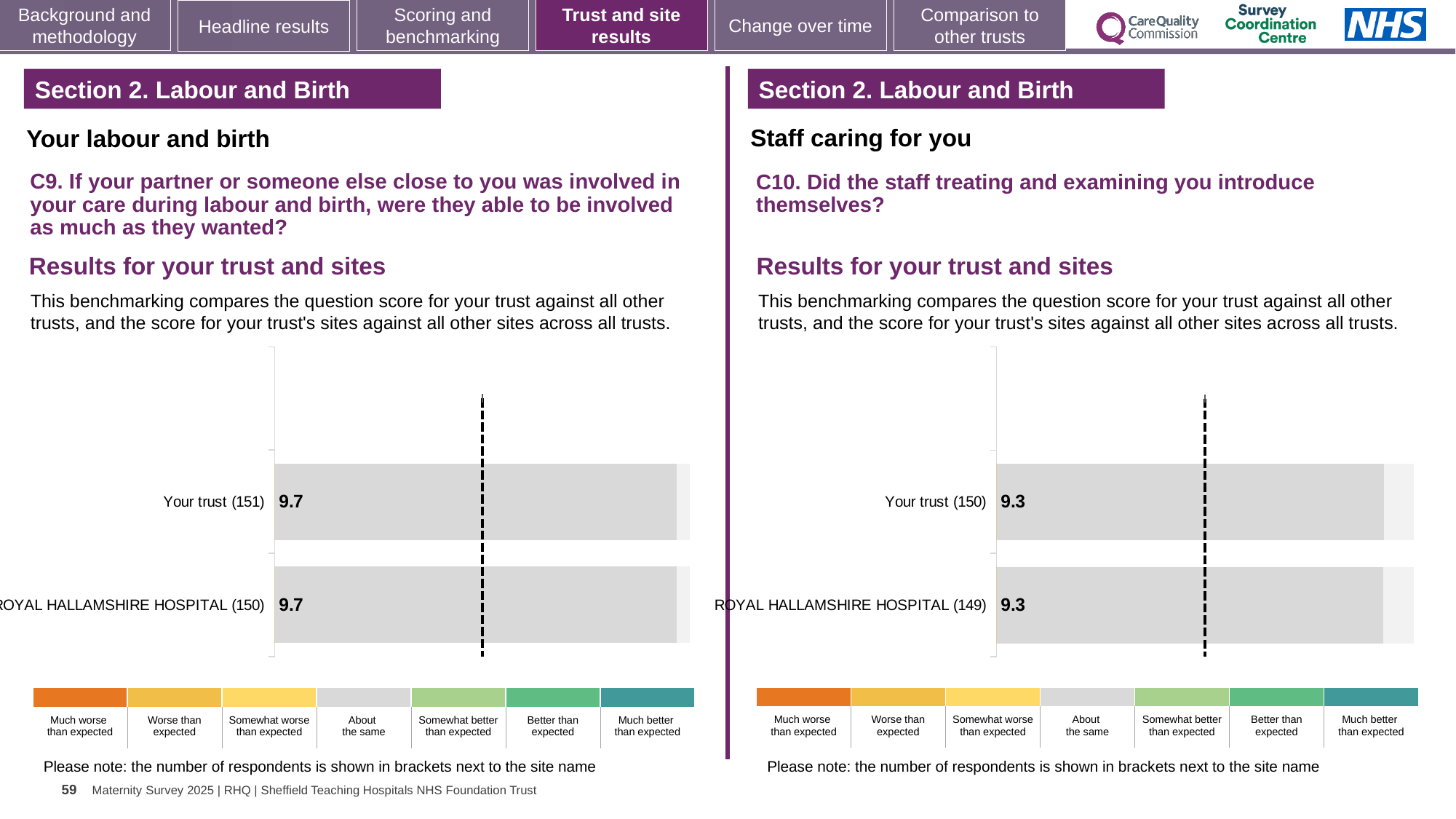
On the right chart (C10), what is the difference between the score for Your trust and the score for ROYAL HALLAMSHIRE HOSPITAL? 0 What kind of chart is the right chart (C10)? bar chart On the right chart (C10), which benchmark category in the colour key do the grey bars correspond to? About the same On the left chart (C9), how many respondents are shown in brackets for Your trust? 151 On the left chart (C9), what is the difference between the score for Your trust and the score for ROYAL HALLAMSHIRE HOSPITAL? 0 On the right chart (C10), what is the score for ROYAL HALLAMSHIRE HOSPITAL (149)? 9.3 On the right chart (C10), what is the score for Your trust (150)? 9.3 On the right chart (C10), how many bars are plotted? 2 What kind of chart is the left chart (C9)? bar chart On the left chart (C9), what is the score for Your trust (151)? 9.7 On the left chart (C9), what is the score for ROYAL HALLAMSHIRE HOSPITAL (150)? 9.7 On the left chart (C9), how many bars are plotted? 2